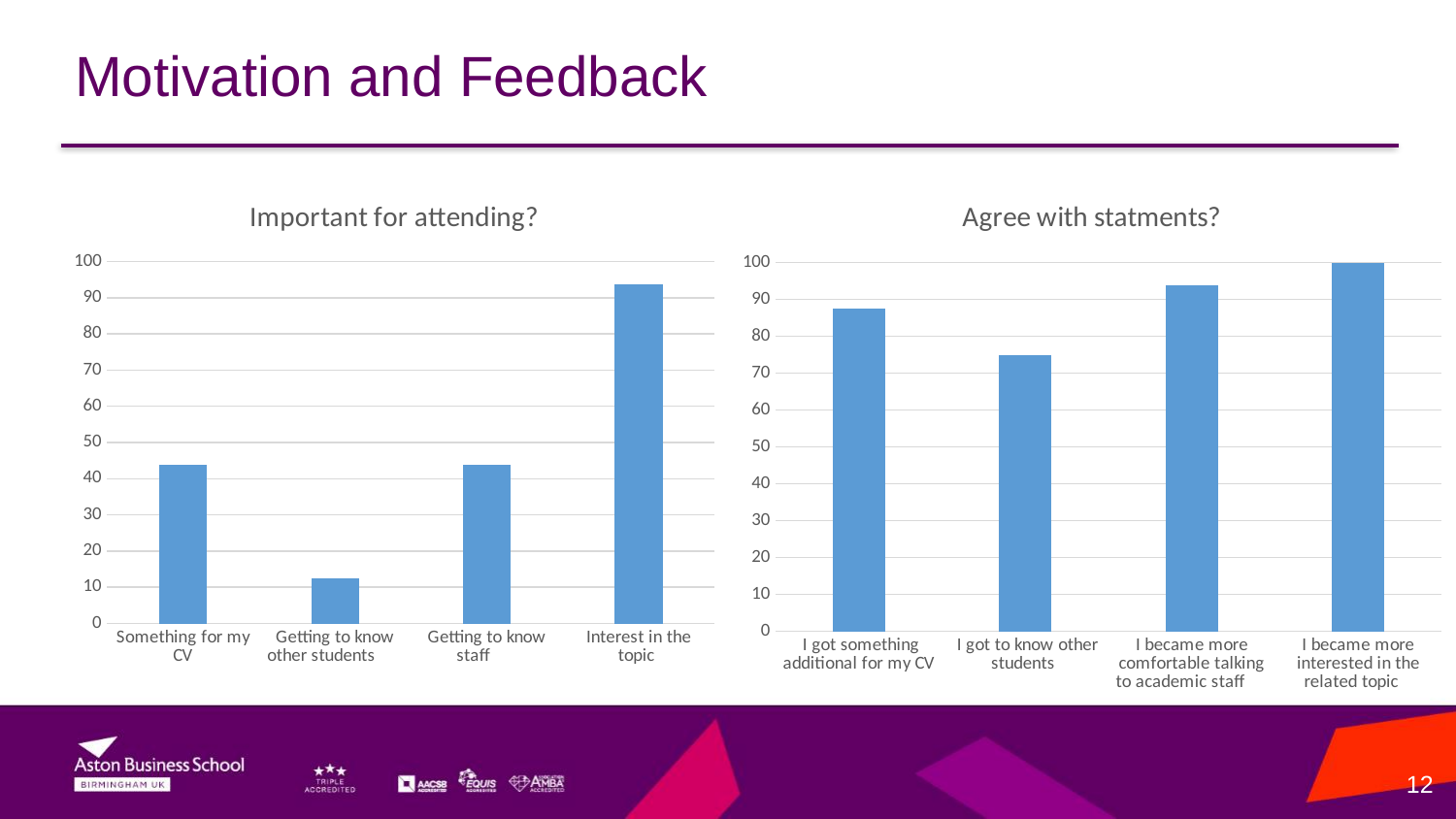
In the 'Agree with statments?' chart, which statement has the lowest value? I got to know other students In the 'Important for attending?' chart, which category has the lowest value? Getting to know other students What is the title of the chart on the right side of the slide? Agree with statments? In the 'Important for attending?' chart, is the value for 'Getting to know other students' greater or less than 20? less In the 'Agree with statments?' chart, which is larger: 'I got something additional for my CV' or 'I got to know other students'? I got something additional for my CV In the 'Agree with statments?' chart, which statement has the highest value? I became more interested in the related topic How many categories are shown in the 'Important for attending?' chart? 4 In the 'Important for attending?' chart, is the value for 'Something for my CV' greater or less than 50? less What type of chart is the 'Agree with statments?' chart? bar chart In the 'Important for attending?' chart, is the value for 'Interest in the topic' greater or less than 90? greater In the 'Important for attending?' chart, which category has the highest value? Interest in the topic